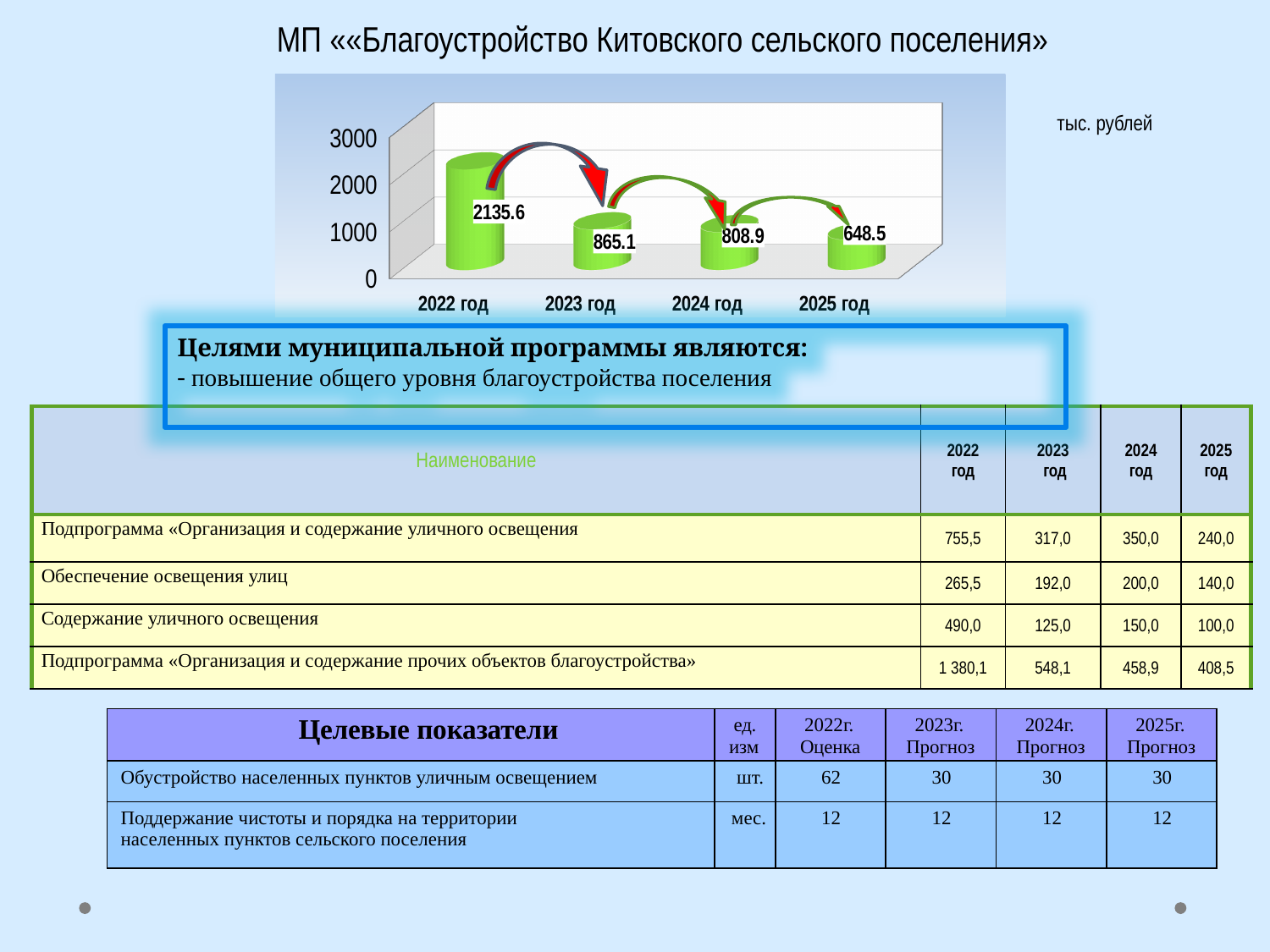
What is the value shown for 2025 год on the chart? 648.5 What is the difference between the values for 2022 год and 2023 год on the chart? 1270.5 Do the values on the chart rise or fall from 2022 год to 2025 год? fall What is the difference between the values for 2024 год and 2025 год on the chart? 160.4 Is the value for 2022 год greater or less than 2000? greater What is the value shown for 2024 год on the chart? 808.9 Which year has the lowest value on the chart? 2025 год Which year has the highest value on the chart? 2022 год What is the value shown for 2022 год on the chart? 2135.6 Which is larger on the chart, the value for 2023 год or the value for 2024 год? 2023 год How many years are shown on the chart's x axis? 4 What is the value shown for 2023 год on the chart? 865.1